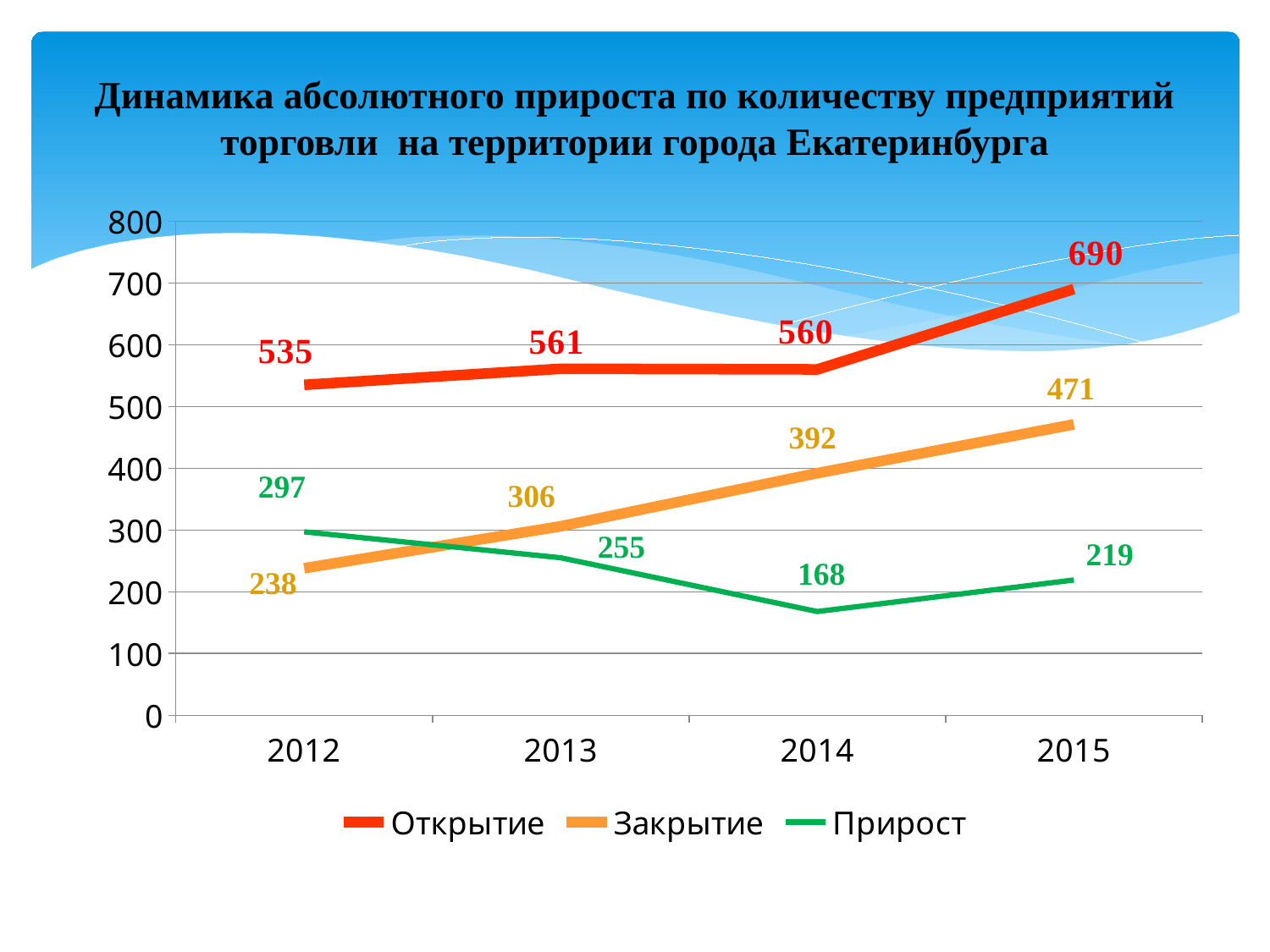
What is the value of Закрытие in 2013? 306 What colour is the Прирост line? green What kind of chart is this? line chart What is the value of Прирост in 2014? 168 In which year is Закрытие highest? 2015 How many years are shown on the x axis? 4 What is the value of Открытие in 2015? 690 How many series does the legend list? 3 In which year is Прирост lowest? 2014 Which is larger in 2014: Закрытие or Прирост? Закрытие Does the Закрытие series rise or fall from 2012 to 2015? rise What is the difference between Открытие and Закрытие in 2012? 297